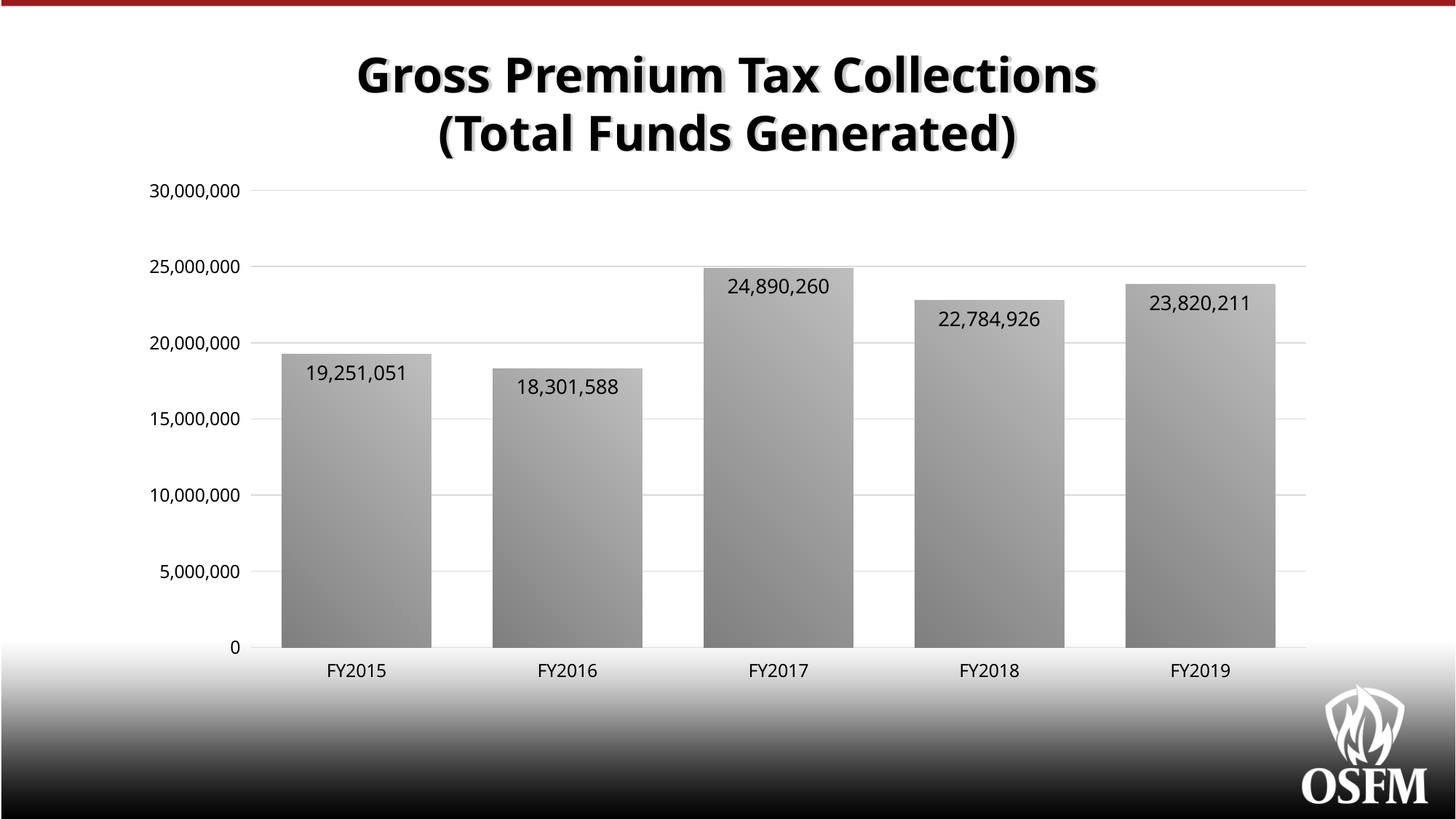
Which is larger, the value for FY2018 or the value for FY2019? FY2019 What is the value for FY2019? 23,820,211 What is the difference between the FY2019 and FY2018 values? 1,035,285 Which fiscal year has the lowest value? FY2016 What is the value for FY2015? 19,251,051 What is the title of the chart? Gross Premium Tax Collections (Total Funds Generated) How many fiscal years are shown on the chart? 5 What kind of chart is shown on the slide? bar chart What is the value for FY2017? 24,890,260 Which fiscal year has the highest value? FY2017 Is the value for FY2016 greater or less than 20,000,000? less What is the difference between the FY2017 and FY2016 values? 6,588,672